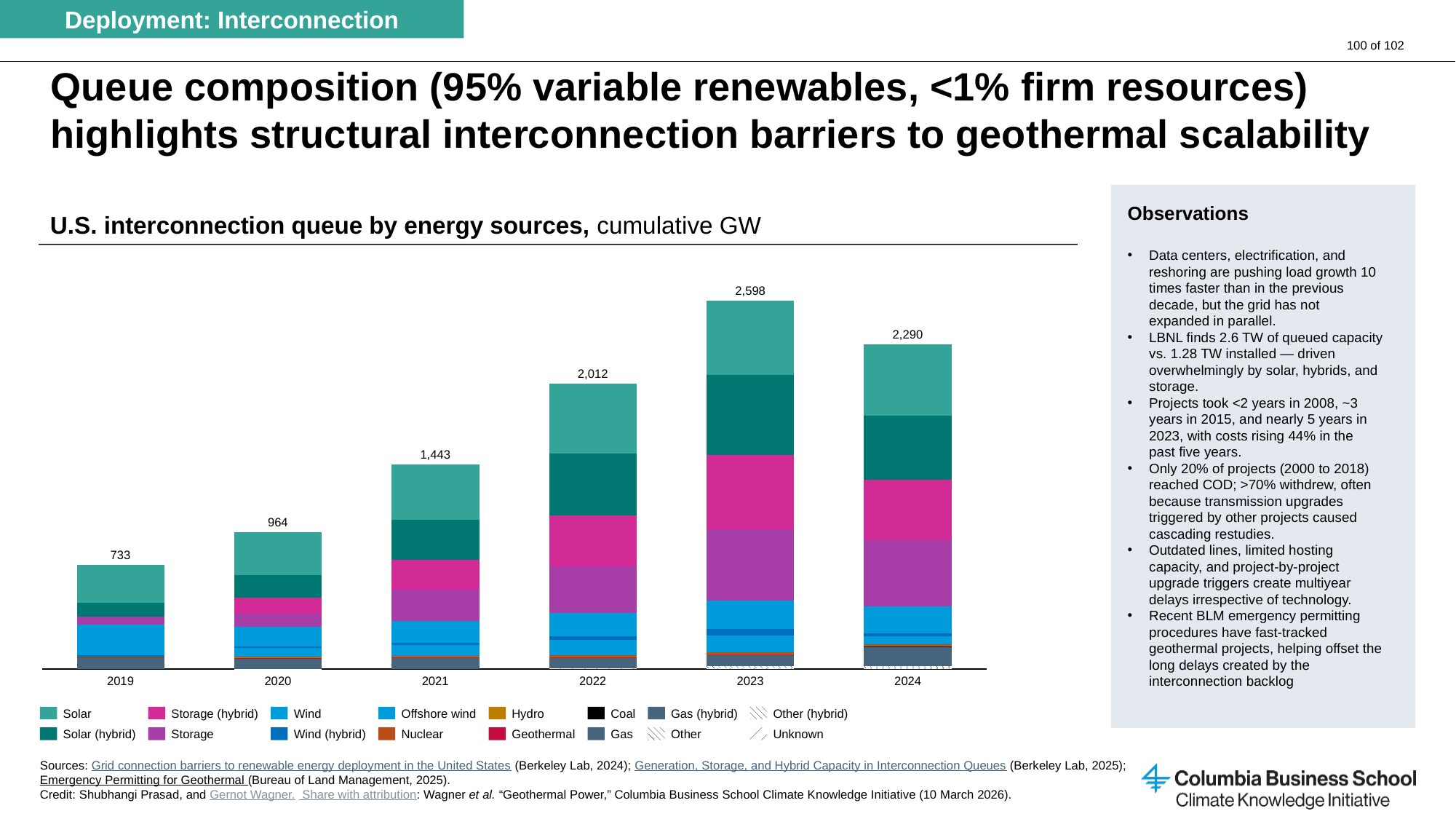
How many energy source categories does the legend list? 16 What is the total cumulative GW in the U.S. interconnection queue shown for 2023? 2,598 Which year has the lowest total cumulative GW in the queue? 2019 How many years are shown on the x axis of the chart? 6 What kind of chart is used to show the U.S. interconnection queue by energy sources? Stacked bar chart What is the total cumulative GW shown for 2021? 1,443 What is the total cumulative GW shown for 2019? 733 Which year has the highest total cumulative GW in the queue? 2023 Which year has a larger total, 2020 or 2024? 2024 By how much does the total for 2023 exceed the total for 2024? 308 What is the difference between the 2022 total and the 2021 total? 569 Does the total cumulative GW rise or fall from 2019 to 2023? Rise